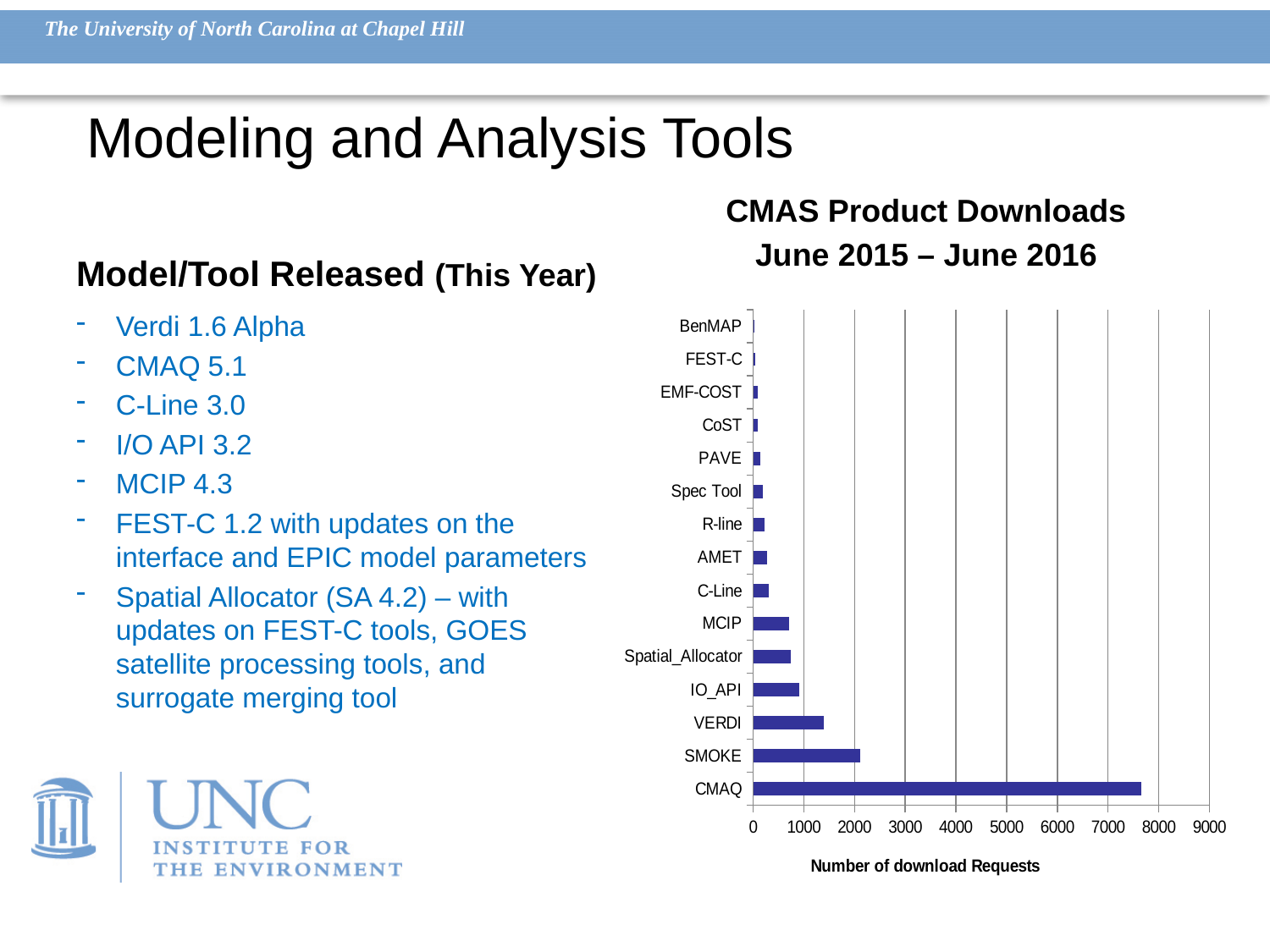
What is the label on the horizontal axis of the chart? Number of download Requests Is the number of download requests for CMAQ greater or less than 7000? greater Which has more download requests, SMOKE or VERDI? SMOKE Is the number of download requests for SMOKE greater or less than 1000? greater What is the title of the chart? CMAS Product Downloads June 2015 – June 2016 Which has more download requests, MCIP or C-Line? MCIP How many products are listed on the chart? 15 Which product has the highest number of download requests? CMAQ Is the number of download requests for VERDI greater or less than 2000? less What kind of chart is shown on the slide? bar chart